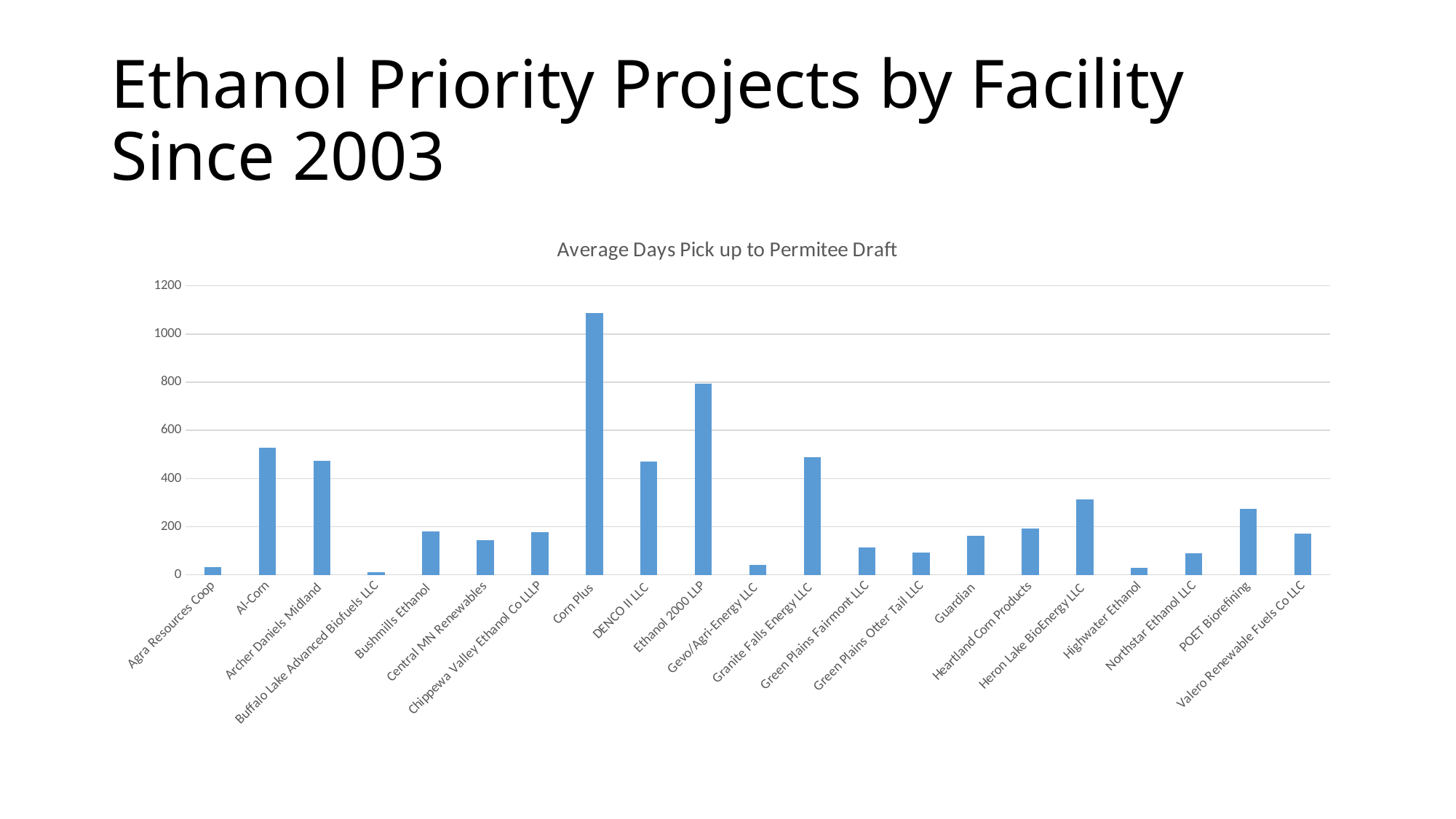
Which facility has the highest average days from pick up to permitee draft? Corn Plus Which facility has the lowest average days from pick up to permitee draft? Buffalo Lake Advanced Biofuels LLC How many facilities are shown on the x axis of the chart? 21 Which has a higher value, POET Biorefining or Highwater Ethanol? POET Biorefining What is the title of the chart? Average Days Pick up to Permitee Draft Is the value for Archer Daniels Midland greater or less than 600? less What kind of chart is shown on the slide? bar chart Is the value for Gevo/Agri-Energy LLC greater or less than 200? less Is the value for Al-Corn greater or less than 400? greater Which has a higher value, Ethanol 2000 LLP or DENCO II LLC? Ethanol 2000 LLP